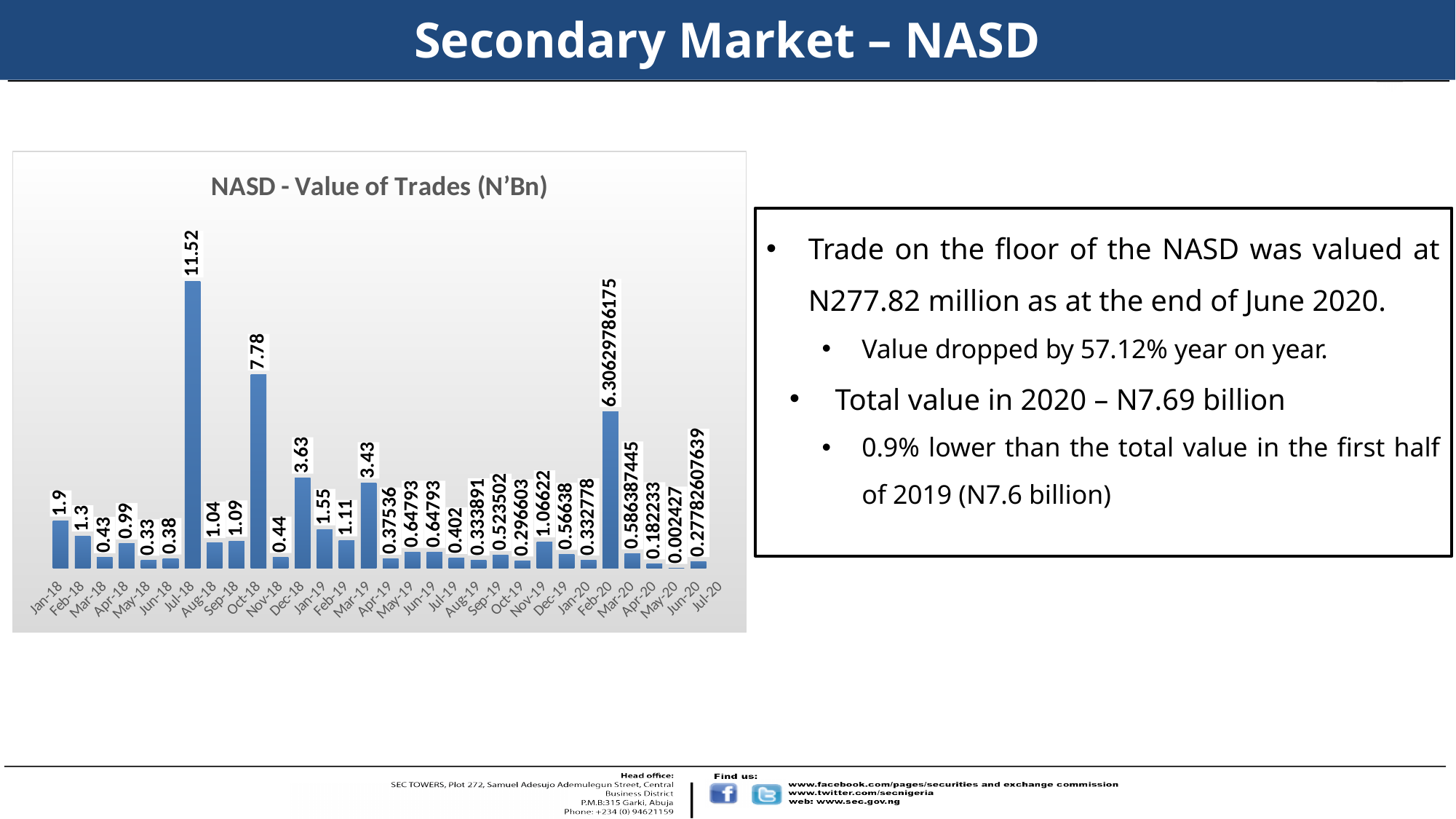
Which month has the lowest value of trades? May-20 Which is larger, the value for Oct-18 or the value for Feb-20? Oct-18 What is the value of trades for Jul-18? 11.52 What type of chart is shown on the slide? Bar chart What is the value of trades for Feb-20? 6.30629786175 What is the value of trades for Dec-18? 3.63 Which month has the highest value of trades? Jul-18 What is the difference between the values for Jul-18 and Oct-18? 3.74 What is the difference between the values for Jan-18 and Feb-18? 0.6 How many months are labelled on the x axis of the chart? 31 What is the value of trades for Jun-20? 0.2778260763 What is the title of the chart? NASD - Value of Trades (N'Bn)